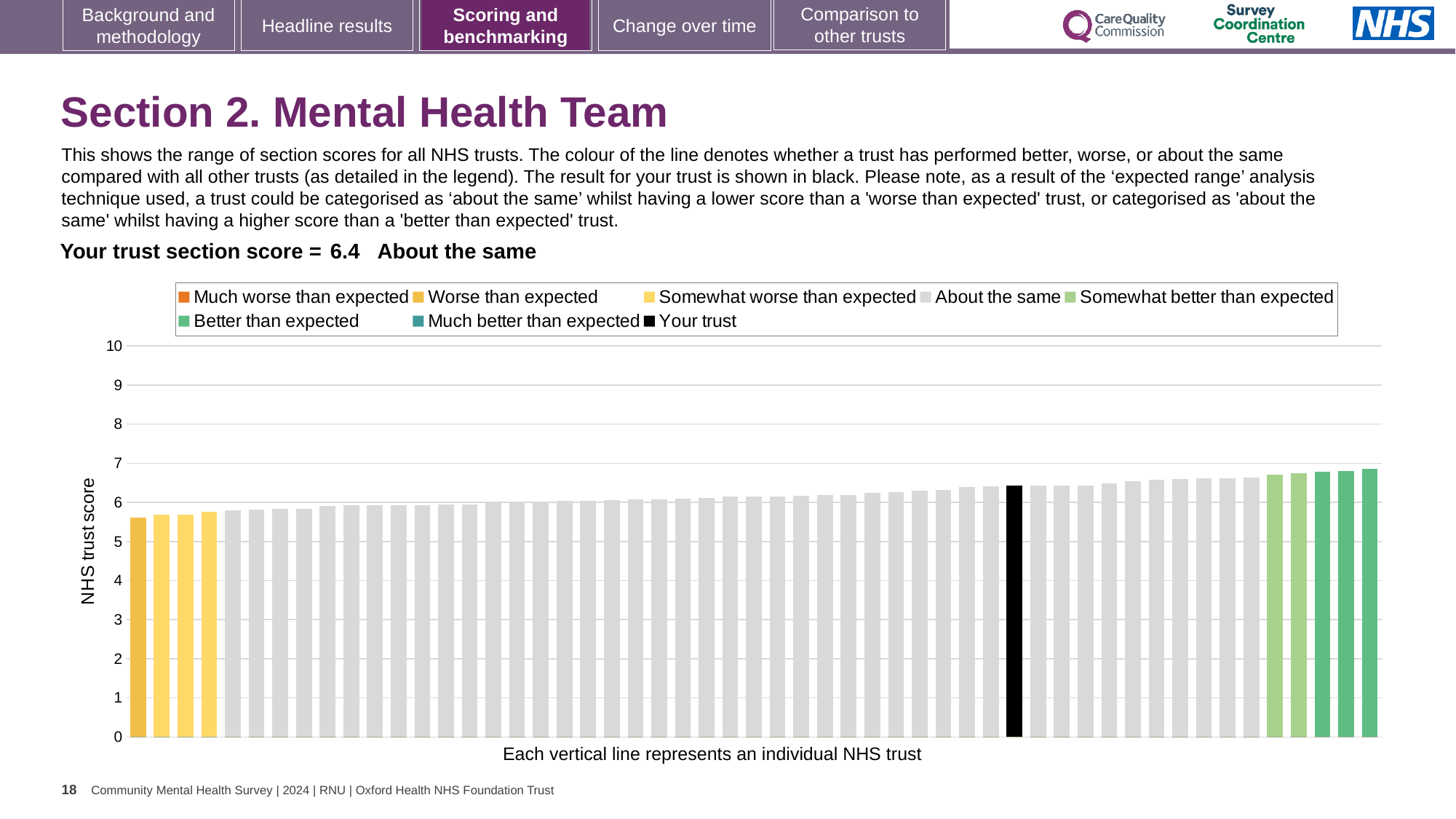
What is the label on the vertical axis of the chart? NHS trust score What is the section score for your trust shown on the slide? 6.4 What colour is the bar representing your trust? black How many bars are coloured as 'Somewhat worse than expected'? 3 Is the value for your trust greater or less than 6? greater How many bars are coloured as 'Better than expected'? 3 Is the value of the lowest bar greater or less than 5? greater Which is larger, the leftmost bar or the rightmost bar? the rightmost bar What kind of chart is shown on the slide? bar chart How many entries does the chart legend list? 8 Do the bar values rise or fall from left to right along the x axis? rise Is the value of the highest bar greater or less than 7? less